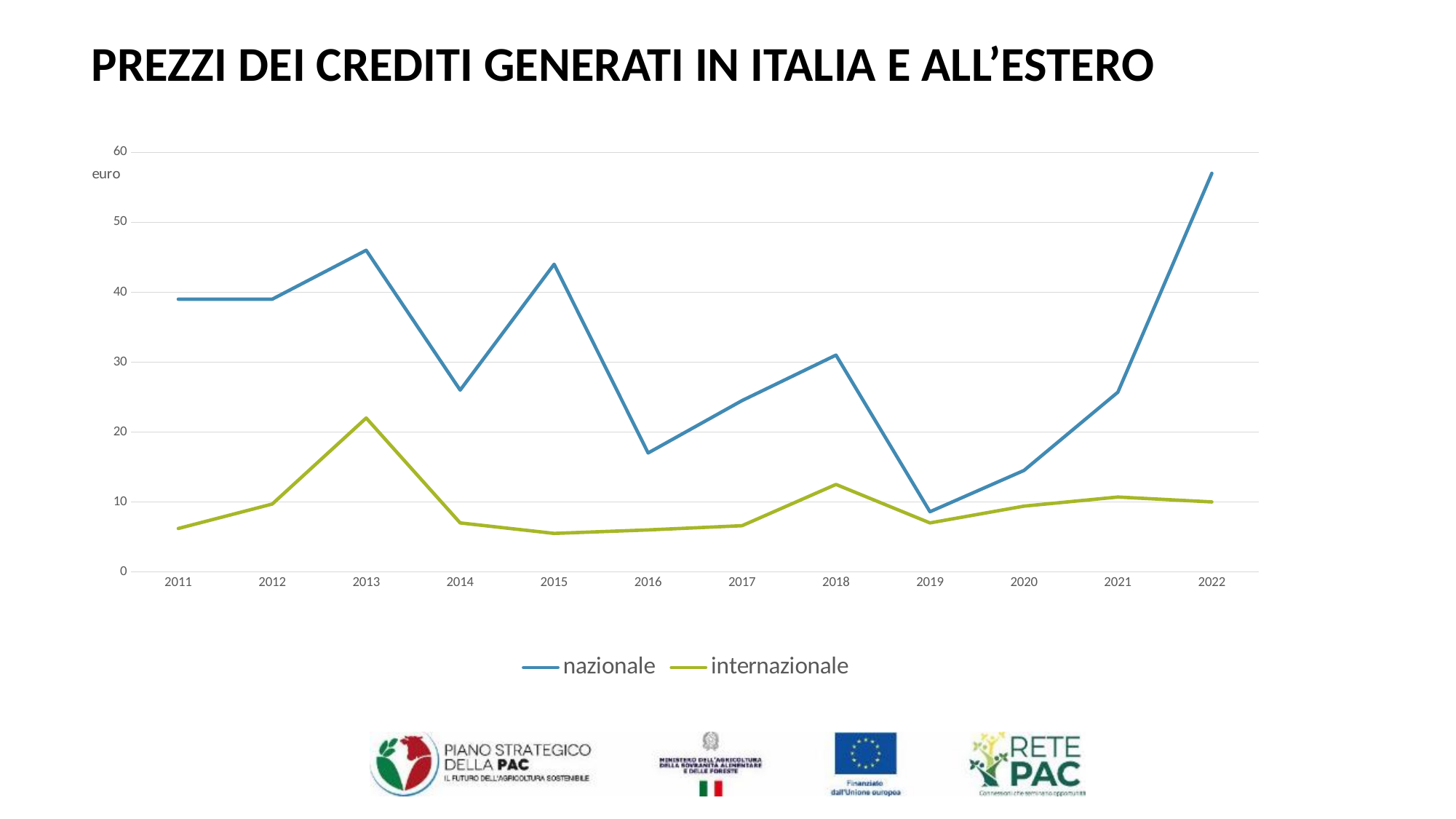
How many years are shown on the x axis? 12 What unit is indicated on the vertical axis? euro Is the value for nazionale in 2016 greater or less than 20? less In which year does the nazionale series reach its highest value? 2022 What kind of chart is shown on the slide? line chart In 2013, which series has the larger value, nazionale or internazionale? nazionale Does the nazionale series rise or fall from 2019 to 2022? rise How many series does the legend list? 2 Is the value for internazionale in 2013 greater or less than 20? greater In which year does the nazionale series reach its lowest value? 2019 Is the value for nazionale in 2022 greater or less than 50? greater In which year does the internazionale series reach its highest value? 2013